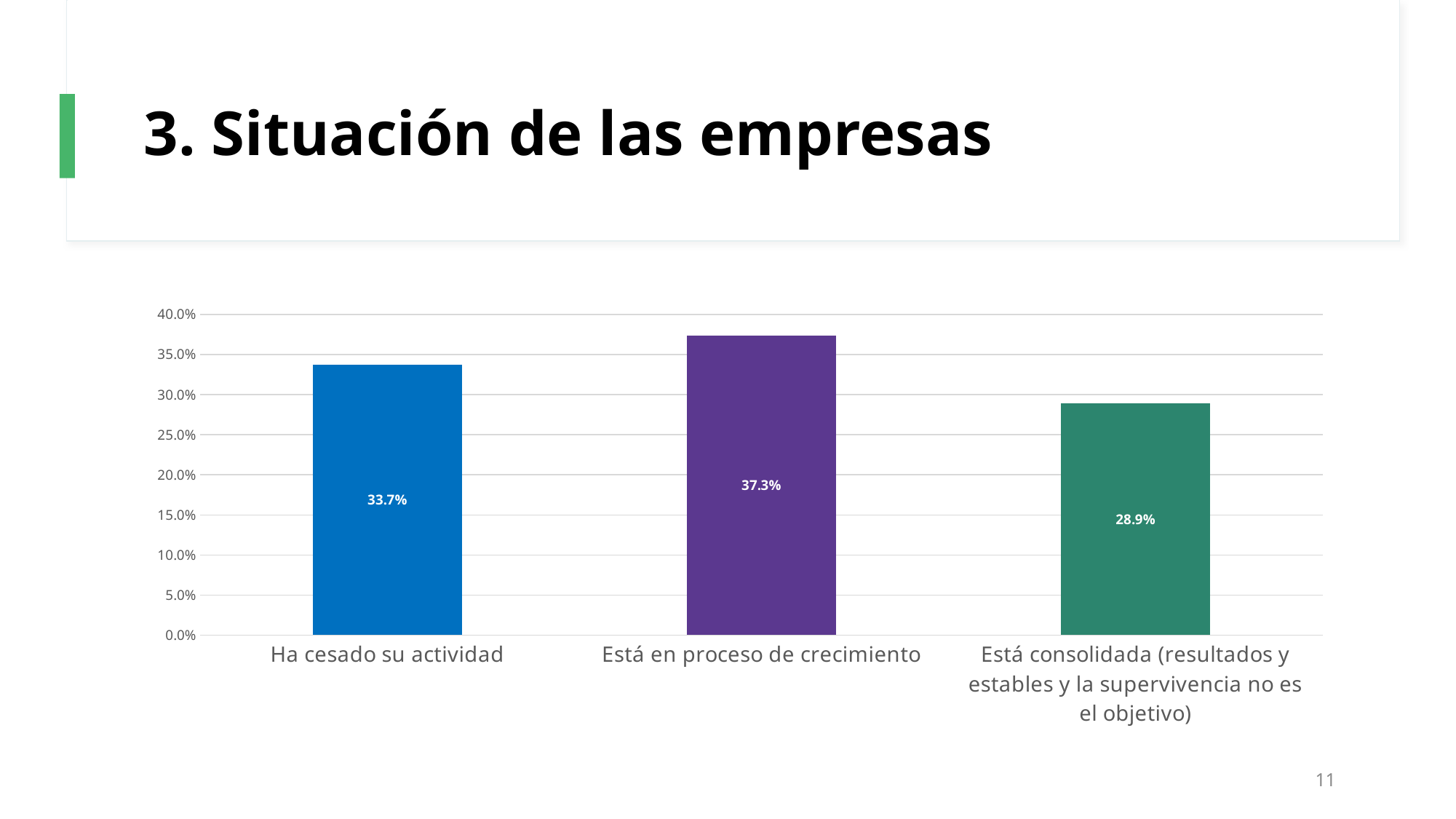
Which category has the highest value? Está en proceso de crecimiento What is the value for 'Está en proceso de crecimiento'? 37.3% What is the value for 'Está consolidada (resultados y estables y la supervivencia no es el objetivo)'? 28.9% What kind of chart is shown on the slide? Bar chart Which category has the lowest value? Está consolidada (resultados y estables y la supervivencia no es el objetivo) Is the value for 'Está en proceso de crecimiento' greater or less than 35.0%? greater What is the difference between the values for 'Está en proceso de crecimiento' and 'Ha cesado su actividad'? 3.6% What is the title of the slide containing the chart? 3. Situación de las empresas How many categories are shown in the chart? 3 Which is larger: the value for 'Ha cesado su actividad' or the value for 'Está consolidada'? Ha cesado su actividad What is the value for 'Ha cesado su actividad'? 33.7% What is the difference between the values for 'Ha cesado su actividad' and 'Está consolidada'? 4.8%